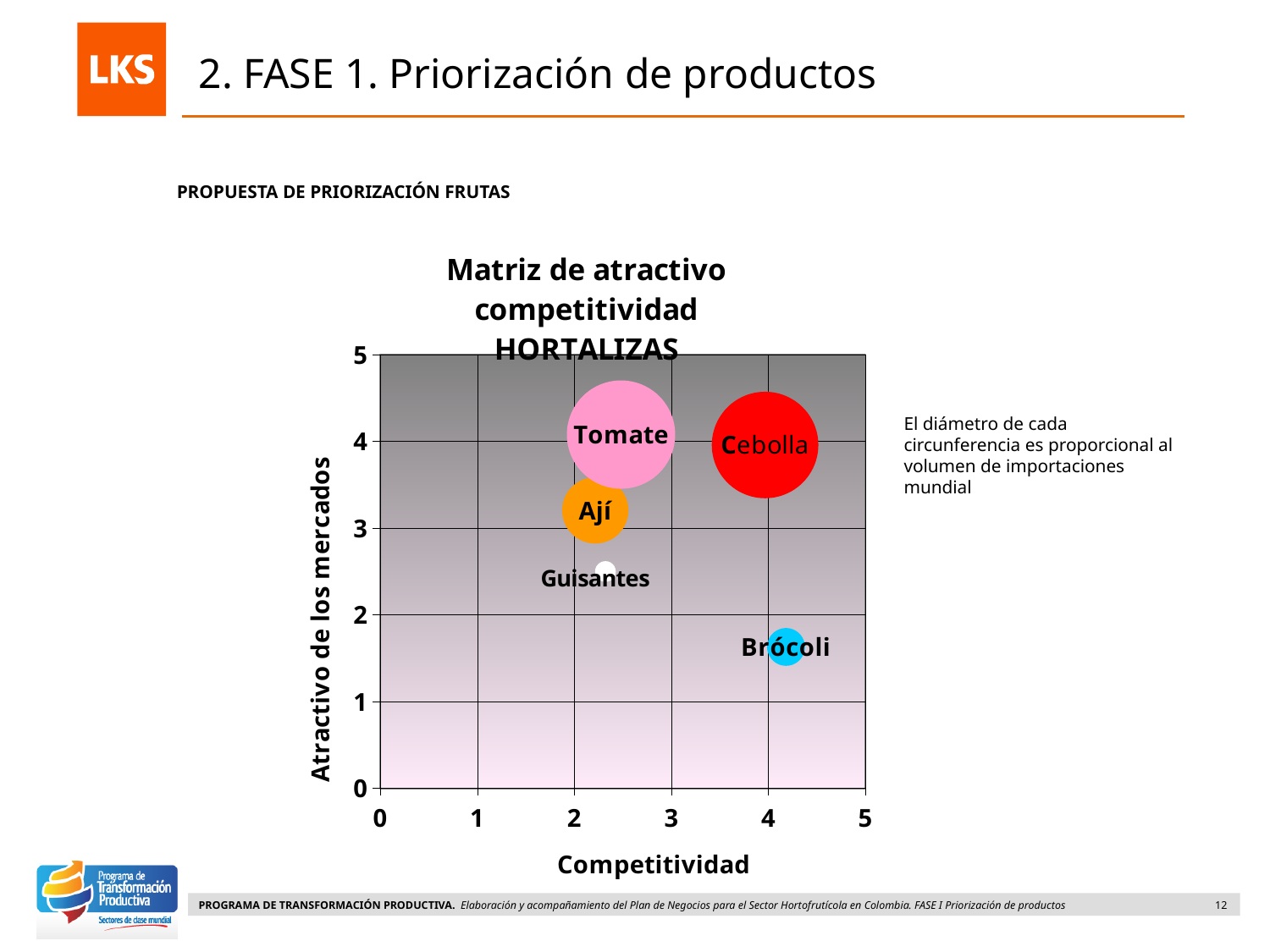
Which has the higher 'Atractivo de los mercados' value, Guisantes or Brócoli? Guisantes Which product has the lowest 'Atractivo de los mercados' value? Brócoli How many products are plotted in the 'Matriz de atractivo competitividad HORTALIZAS' chart? 5 What kind of chart is shown on the slide? bubble chart Is the 'Competitividad' value for Brócoli greater or less than 3? greater Is the 'Atractivo de los mercados' value for Guisantes greater or less than 3? less Which product is represented by the smallest bubble in the chart? Guisantes What is the title of the horizontal axis of the chart? Competitividad Is the 'Atractivo de los mercados' value for Tomate greater or less than 3? greater Which has the higher 'Competitividad' value, Cebolla or Tomate? Cebolla